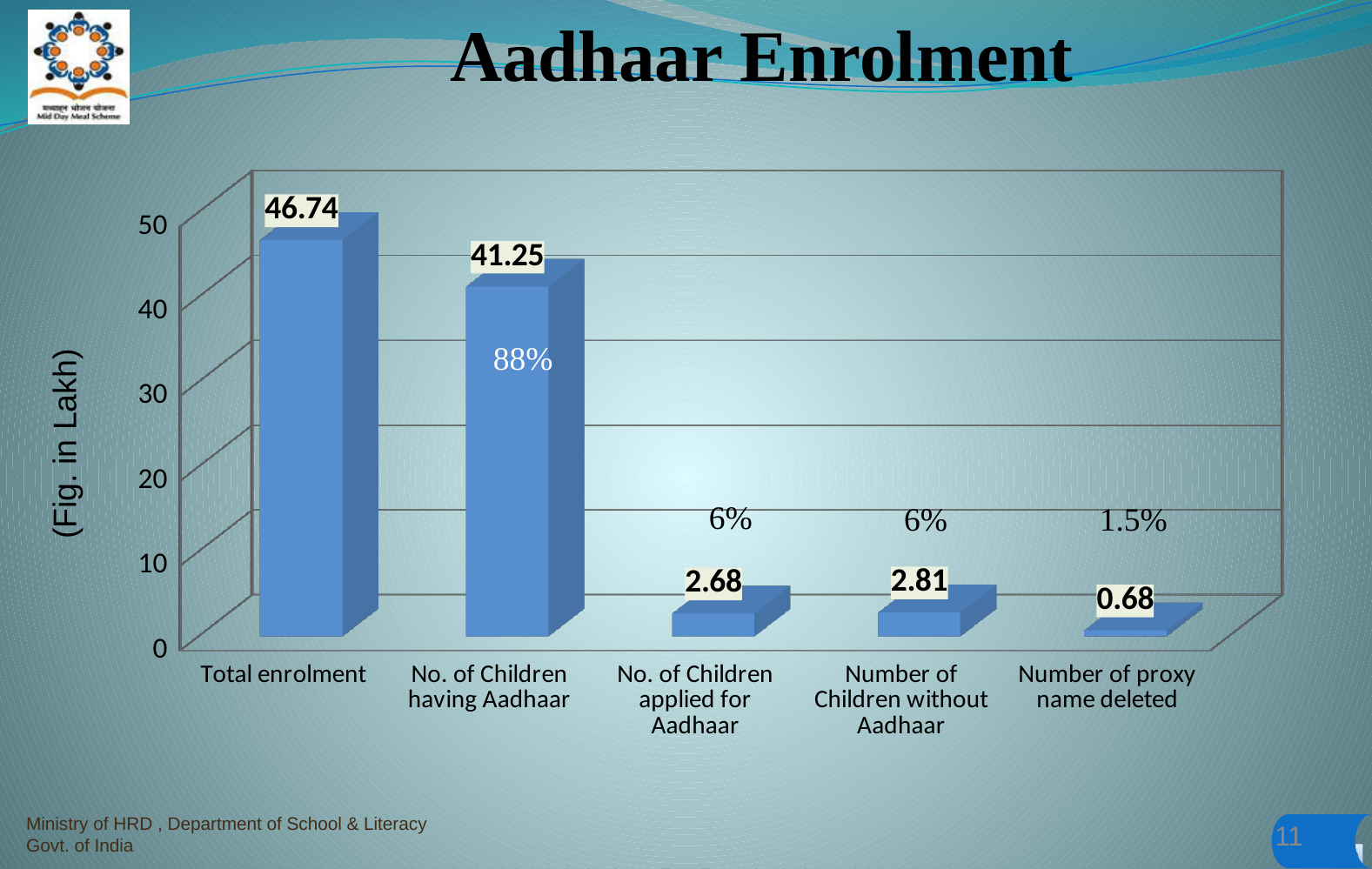
How many categories are shown on the chart? 5 What is the value for Number of proxy name deleted? 0.68 What kind of chart is shown on the slide? Bar chart What is the value for Total enrolment? 46.74 Which category has the lowest value? Number of proxy name deleted What is the difference between Total enrolment and No. of Children having Aadhaar? 5.49 What is the value for Number of Children without Aadhaar? 2.81 What is the value for No. of Children having Aadhaar? 41.25 What percentage is shown above the No. of Children having Aadhaar bar? 88% Is the value for No. of Children having Aadhaar greater or less than 40? greater Which category has the highest value? Total enrolment Which is larger: No. of Children applied for Aadhaar or Number of Children without Aadhaar? Number of Children without Aadhaar